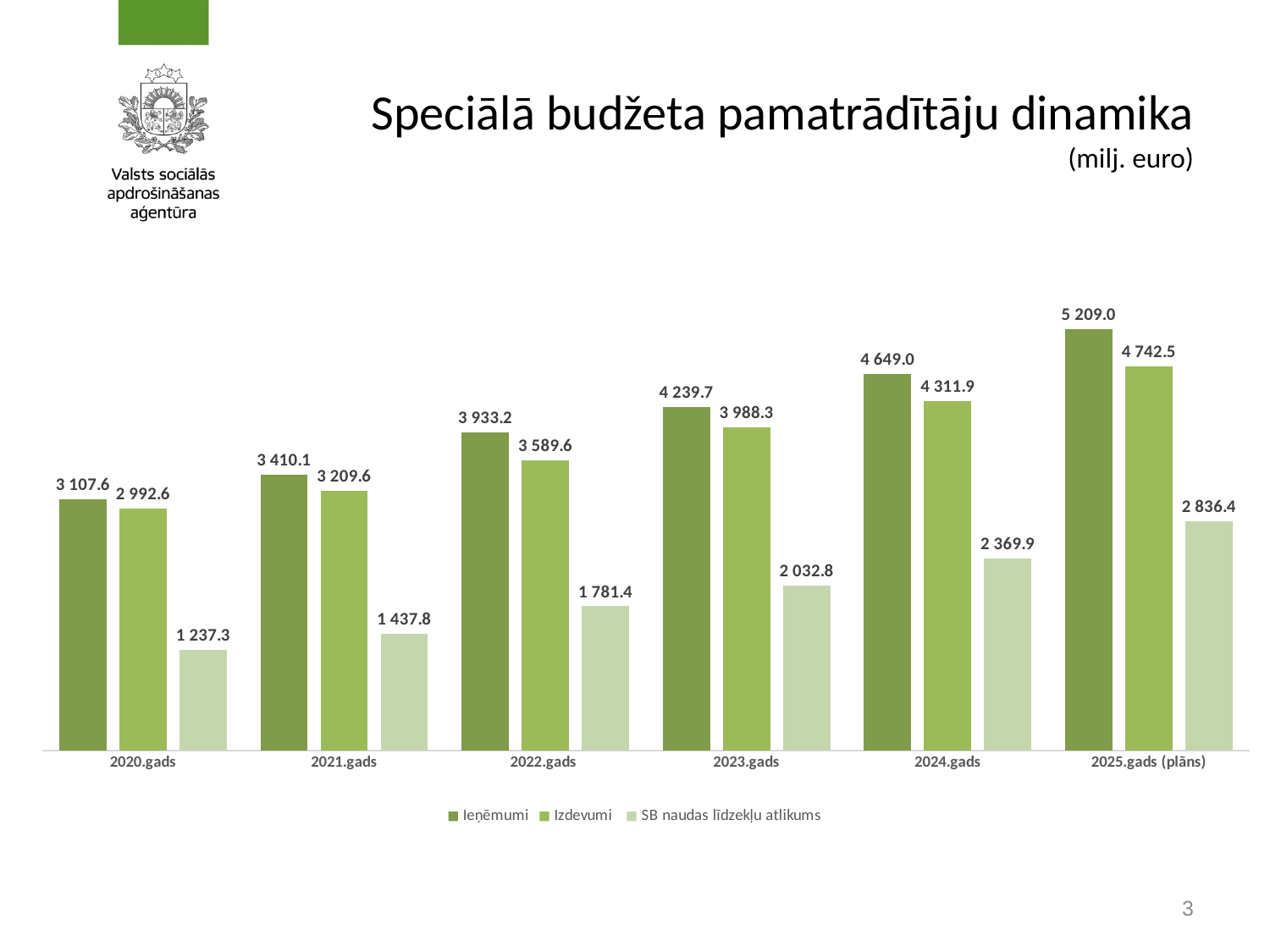
How many years are shown on the x axis? 6 What is the difference between SB naudas līdzekļu atlikums in 2025.gads (plāns) and in 2020.gads? 1 599.1 What is the difference between Ieņēmumi and Izdevumi for 2025.gads (plāns)? 466.5 Which year has the lowest SB naudas līdzekļu atlikums value? 2020.gads Which year has the highest Ieņēmumi value? 2025.gads (plāns) Do the Izdevumi values rise or fall from 2020.gads to 2025.gads (plāns)? Rise How many series does the legend list? 3 What kind of chart is shown on the slide? Bar chart What is the value of SB naudas līdzekļu atlikums for 2025.gads (plāns)? 2 836.4 What is the value of Izdevumi for 2023.gads? 3 988.3 What is the value of Ieņēmumi for 2020.gads? 3 107.6 Which is larger for 2022.gads: Ieņēmumi or Izdevumi? Ieņēmumi